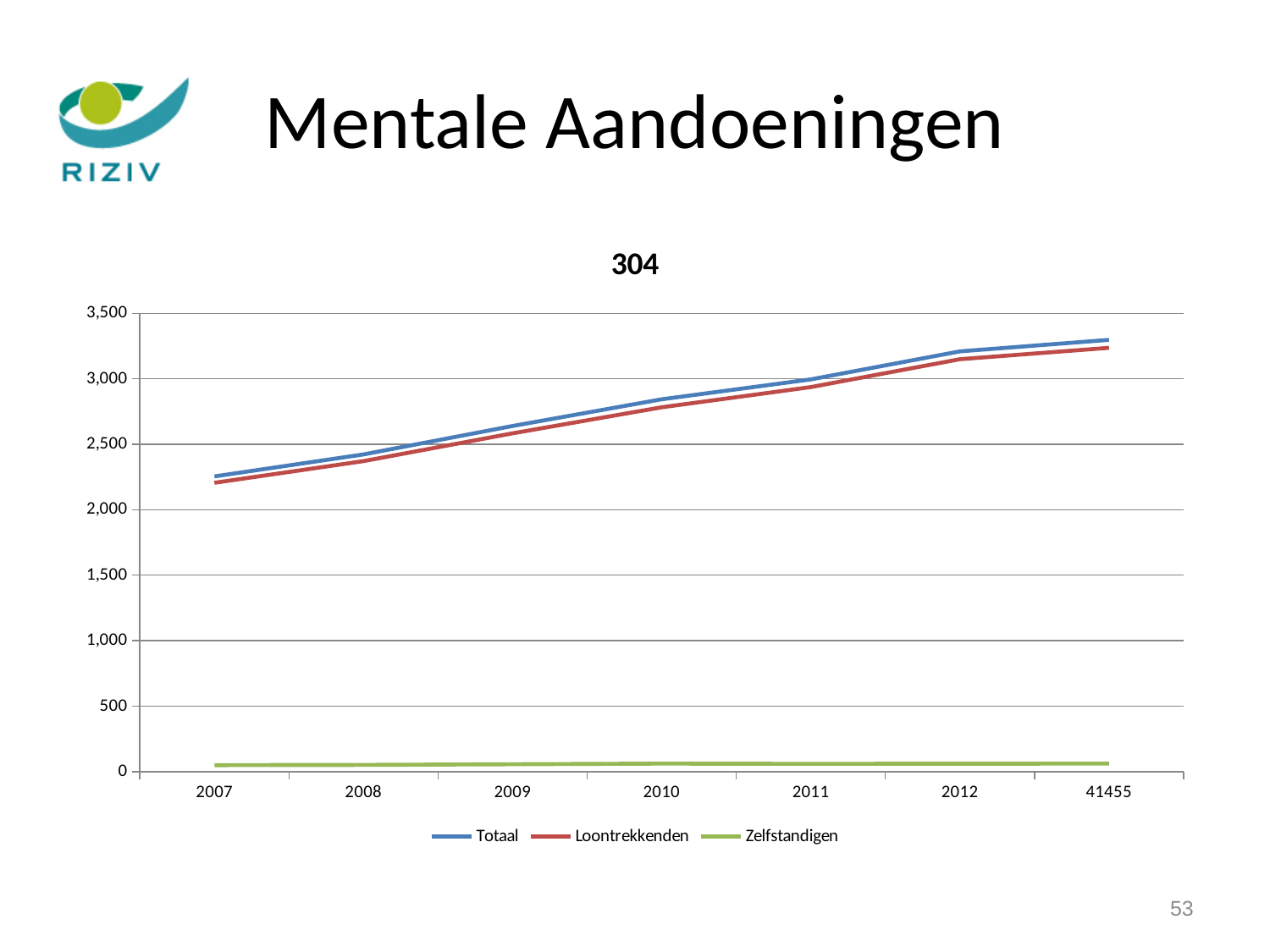
How many series does the legend list? 3 What is the title of the chart? 304 Is the value for Totaal in 2007 greater or less than 2,000? greater Is the value for Zelfstandigen in 2010 greater or less than 500? less In 2010, which is larger: the value for Totaal or the value for Zelfstandigen? Totaal What kind of chart is shown on the slide? line chart Which series has the lowest values across all years? Zelfstandigen Does the Totaal series rise or fall from 2007 to 2012? rise How many points are plotted along the x axis for each series? 7 Which colour is used for the Loontrekkenden series? red Is the value for Loontrekkenden in 2007 greater or less than 2,500? less